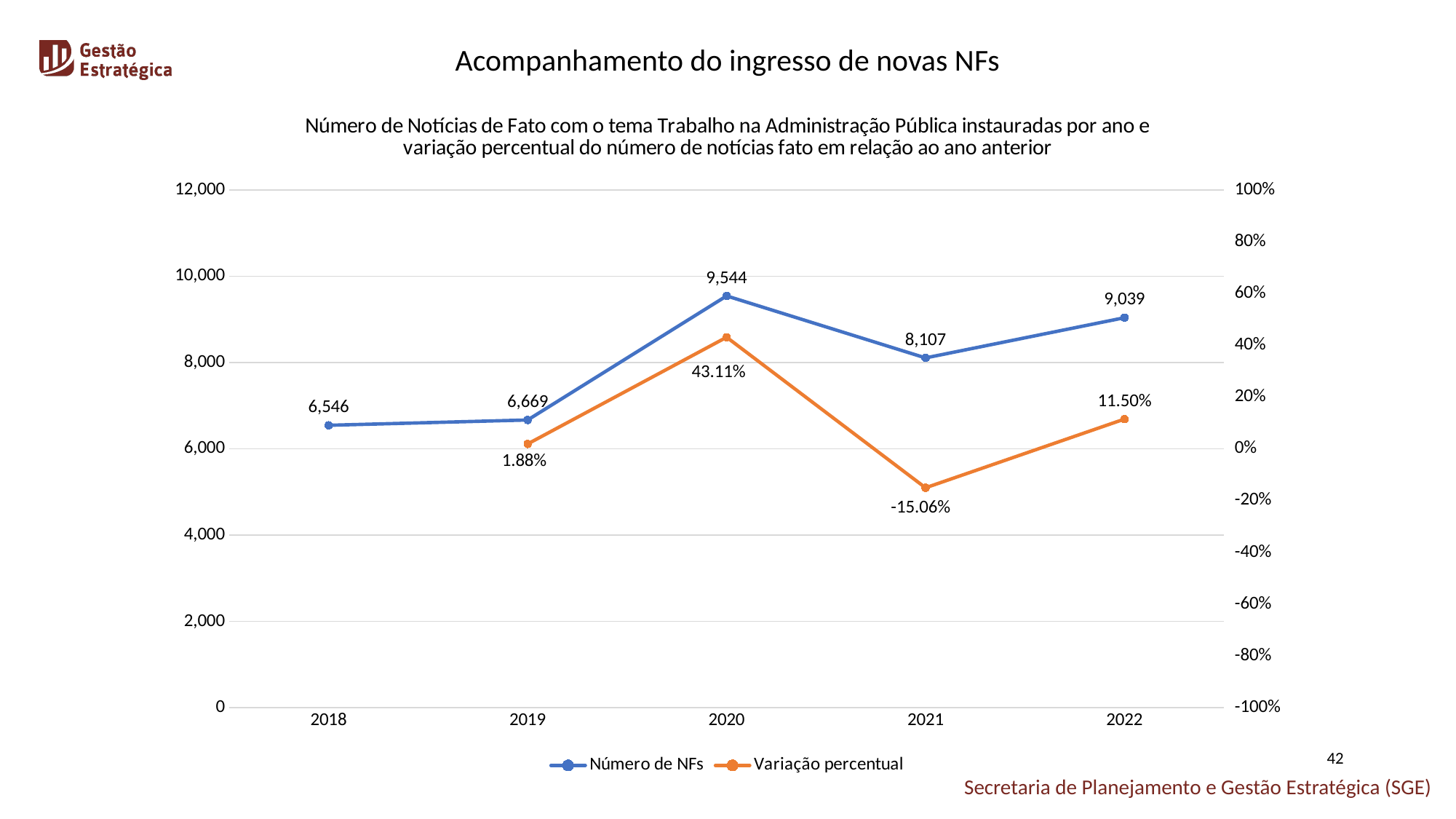
Is the Número de NFs for 2021 greater or less than 8,000? greater What kind of chart is shown on the slide? line chart How many series does the legend list? 2 Which year has the highest Número de NFs? 2020 What is the Variação percentual for 2021? -15.06% What is the difference in Número de NFs between 2020 and 2021? 1,437 How many years are shown on the x axis? 5 What is the value of Número de NFs for 2020? 9,544 Which year has the lowest Variação percentual? 2021 Which is larger, the Número de NFs for 2019 or for 2022? 2022 Does the Número de NFs rise or fall from 2021 to 2022? rise What is the value of Número de NFs for 2018? 6,546